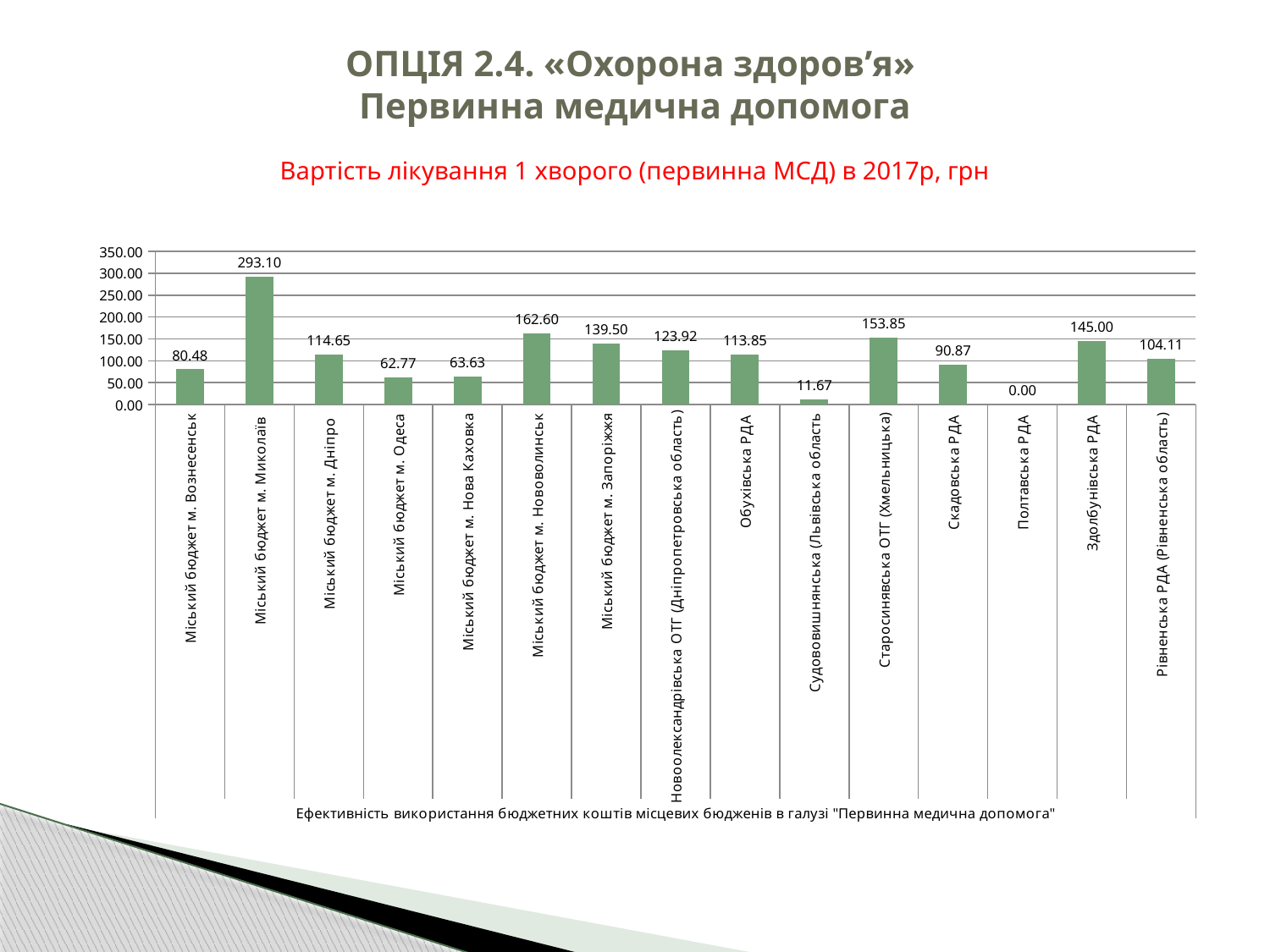
Which category has the lowest value? Полтавська РДА What is the difference between the values for Міський бюджет м. Нововолинськ and Міський бюджет м. Запоріжжя? 23.10 What is the value for Судововишнянська (Львівська область)? 11.67 Which category has the highest value? Міський бюджет м. Миколаїв How many categories are shown on the chart? 15 What is the difference between the values for Міський бюджет м. Миколаїв and Міський бюджет м. Вознесенськ? 212.62 What is the value for Старосинявська ОТГ (Хмельницька)? 153.85 What is the value for Здолбунівська РДА? 145.00 What kind of chart is shown on the slide? Bar chart What is the value for Міський бюджет м. Миколаїв? 293.10 Which is larger, the value for Міський бюджет м. Дніпро or the value for Обухівська РДА? Міський бюджет м. Дніпро What is the title of the chart? Вартість лікування 1 хворого (первинна МСД) в 2017р, грн